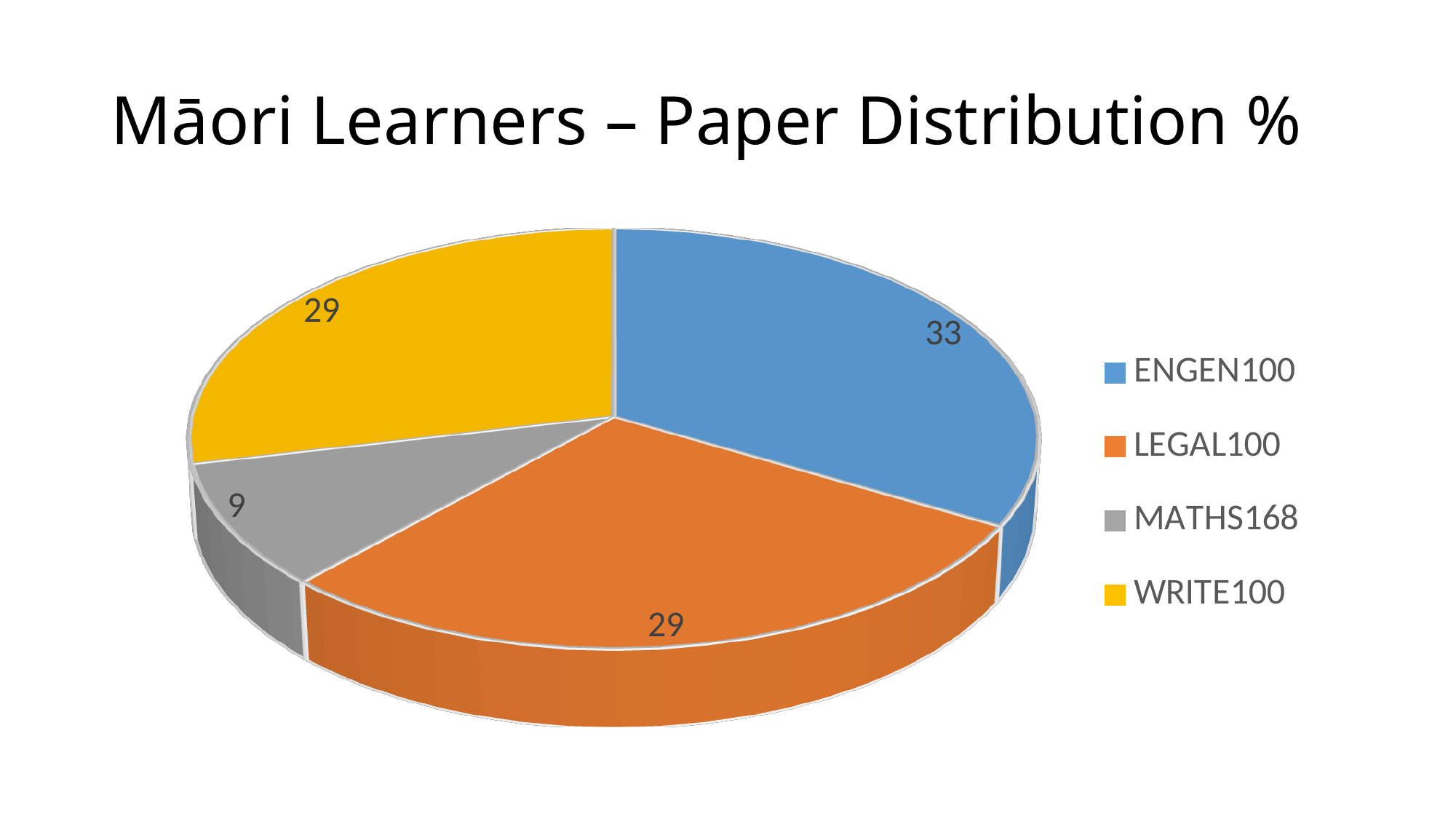
How many slices does the pie chart have? 4 What is the difference between the values for ENGEN100 and MATHS168? 24 What kind of chart is shown on the slide? Pie chart What is the title of the chart? Māori Learners – Paper Distribution % Which paper has the largest slice? ENGEN100 What is the value for WRITE100? 29 What is the value for LEGAL100? 29 What is the value for MATHS168? 9 Which paper has the smallest slice? MATHS168 Which is larger, the value for ENGEN100 or the value for LEGAL100? ENGEN100 Which colour represents WRITE100 in the legend? Yellow What is the value for ENGEN100? 33